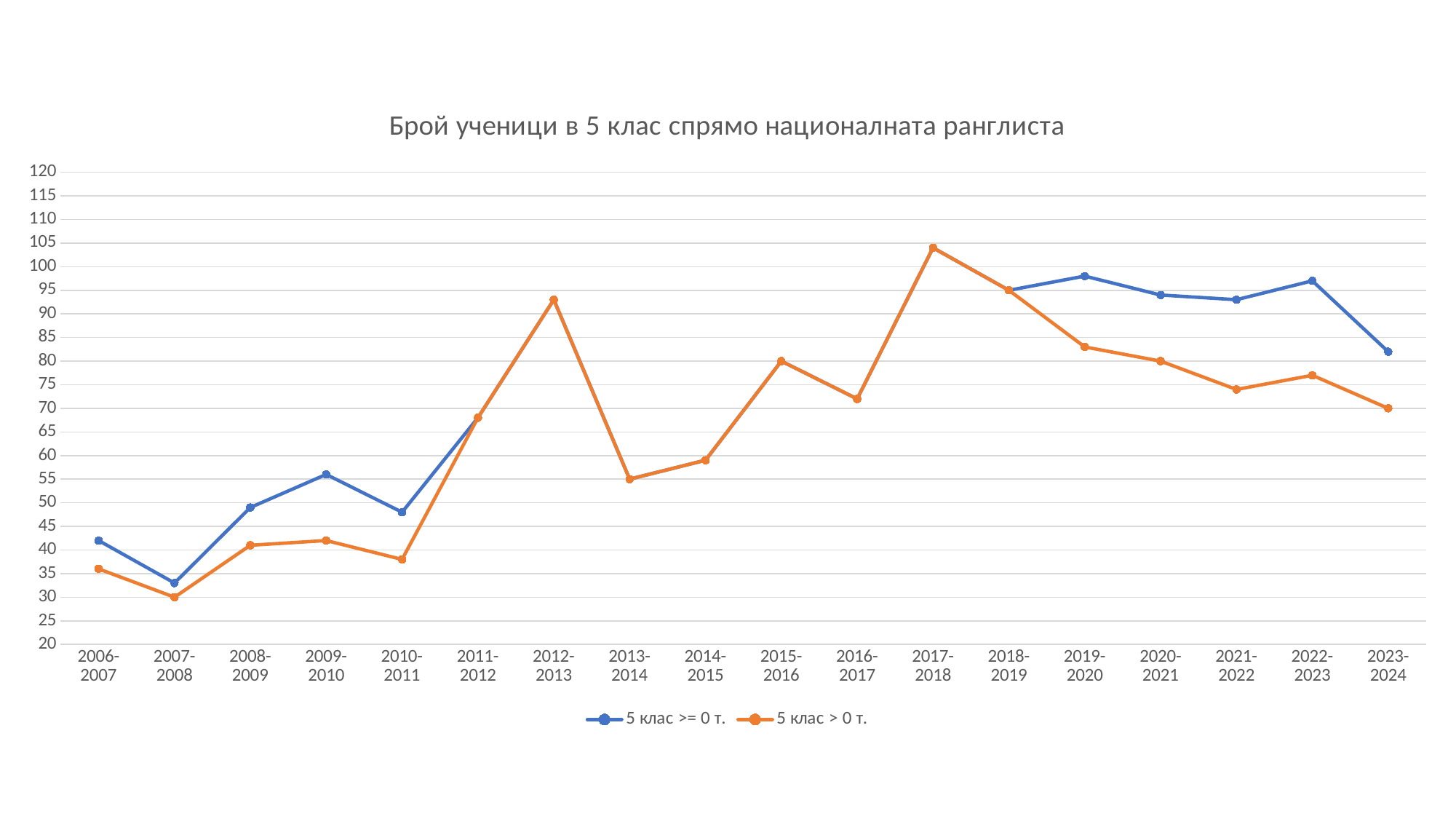
Is the value of '5 клас >= 0 т.' for 2010-2011 greater or less than 50? less How many series does the legend list? 2 In which school year does the series '5 клас > 0 т.' reach its highest value? 2017-2018 What is the value of '5 клас > 0 т.' for 2015-2016? 80 In which school year does the series '5 клас > 0 т.' have its lowest value? 2007-2008 For 2019-2020, which series has the larger value, '5 клас >= 0 т.' or '5 клас > 0 т.'? 5 клас >= 0 т. How many school years are plotted along the x axis? 18 Is the value of '5 клас > 0 т.' for 2012-2013 greater or less than 90? greater Does the series '5 клас > 0 т.' rise or fall from 2017-2018 to 2021-2022? fall What is the title of the chart? Брой ученици в 5 клас спрямо националната ранглиста What kind of chart is shown on the slide? line chart What is the value of '5 клас > 0 т.' for 2023-2024? 70